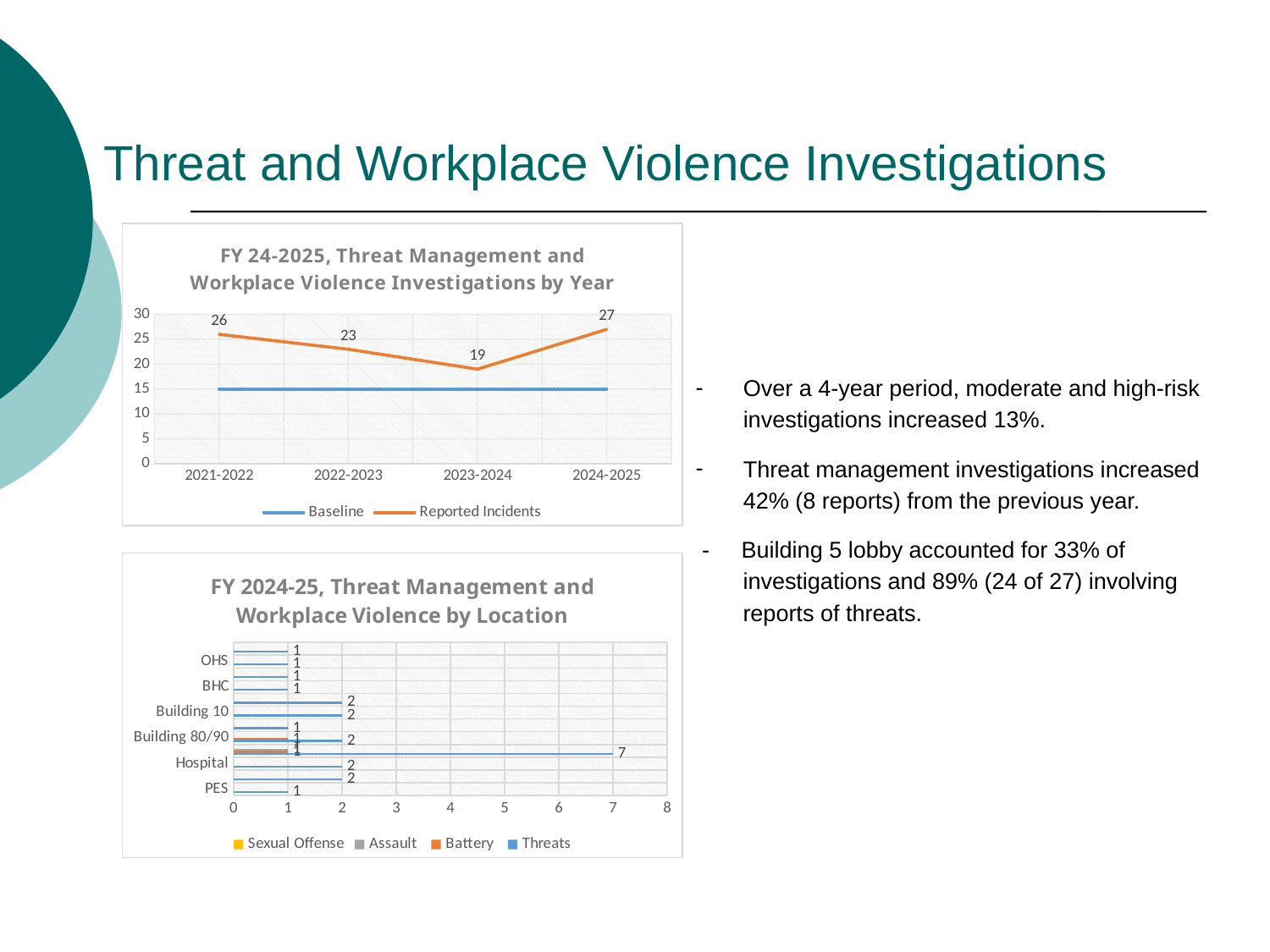
In the top chart (Investigations by Year), what is the Reported Incidents value for 2024-2025? 27 In the top chart (Investigations by Year), which year has the larger Reported Incidents value, 2021-2022 or 2022-2023? 2021-2022 In the top chart (Investigations by Year), which year has the lowest Reported Incidents value? 2023-2024 In the top chart (Investigations by Year), do the Reported Incidents values rise or fall from 2021-2022 to 2023-2024? fall What kind of chart is the bottom chart, 'FY 2024-25, Threat Management and Workplace Violence by Location'? Bar chart How many series does the legend of the top chart (Investigations by Year) list? 2 In the top chart (Investigations by Year), what is the difference between the Reported Incidents values for 2024-2025 and 2023-2024? 8 How many series does the legend of the bottom chart (Workplace Violence by Location) list? 4 In the top chart (Investigations by Year), what is the Reported Incidents value for 2021-2022? 26 What kind of chart is the top chart, 'FY 24-2025, Threat Management and Workplace Violence Investigations by Year'? Line chart In the top chart (Investigations by Year), is the Baseline value for 2022-2023 greater or less than 20? less In the top chart (Investigations by Year), which year has the highest Reported Incidents value? 2024-2025